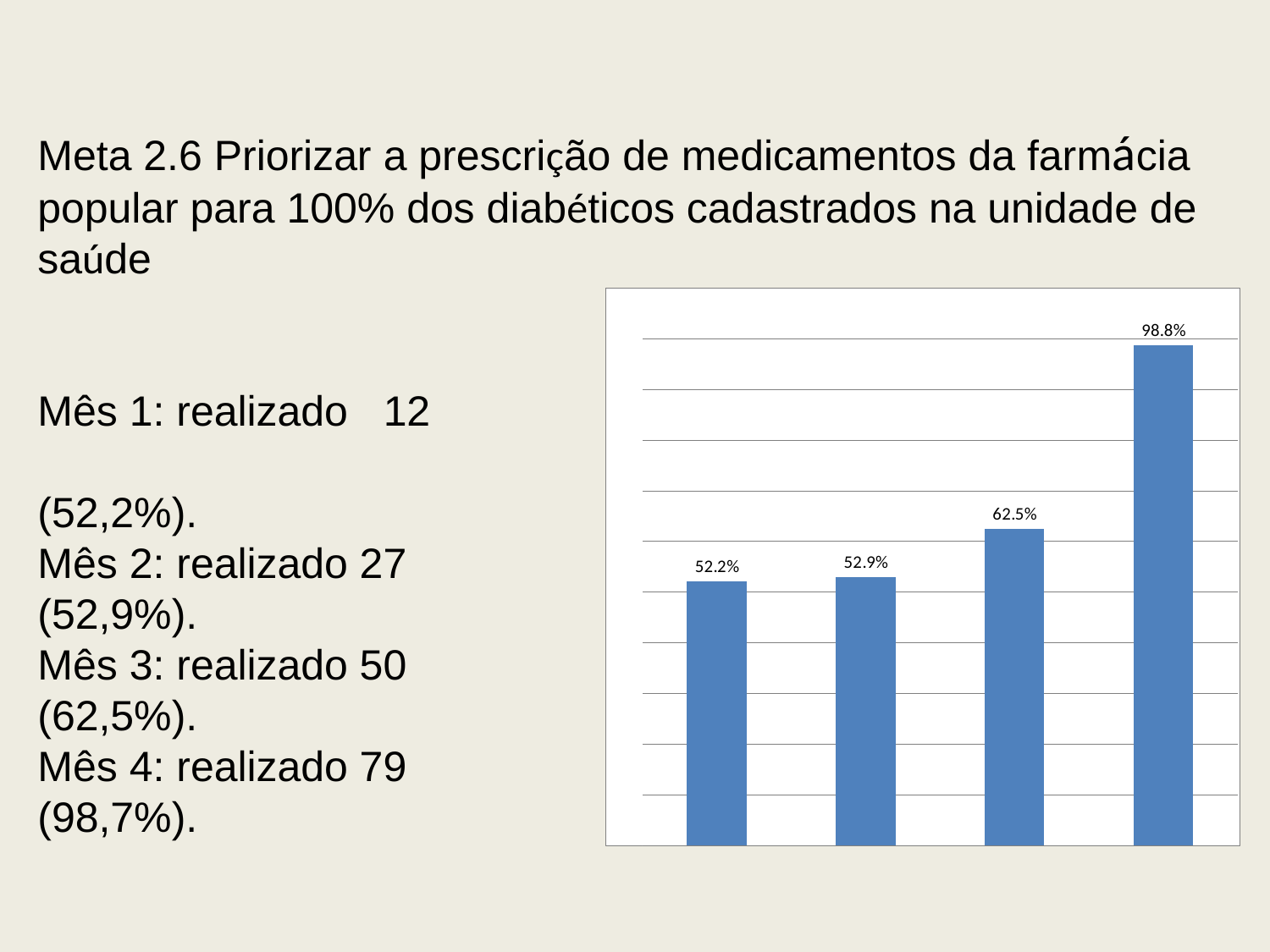
What is the value shown on the second bar of the chart? 52.9% Which bar in the chart has the lowest value? The first (leftmost) bar, 52.2% What is the value shown on the third bar of the chart? 62.5% How many bars are plotted in the chart? 4 What is the difference between the third bar's value and the second bar's value? 9.6% Do the values in the chart rise or fall from left to right? Rise What kind of chart is shown on the slide? Bar chart What is the value shown on the fourth (rightmost) bar of the chart? 98.8% Which bar in the chart has the highest value? The fourth (rightmost) bar, 98.8% What is the difference between the fourth bar's value and the first bar's value? 46.6% Which is larger, the value of the third bar or the value of the second bar? The third bar (62.5%) What is the value shown on the first (leftmost) bar of the chart? 52.2%